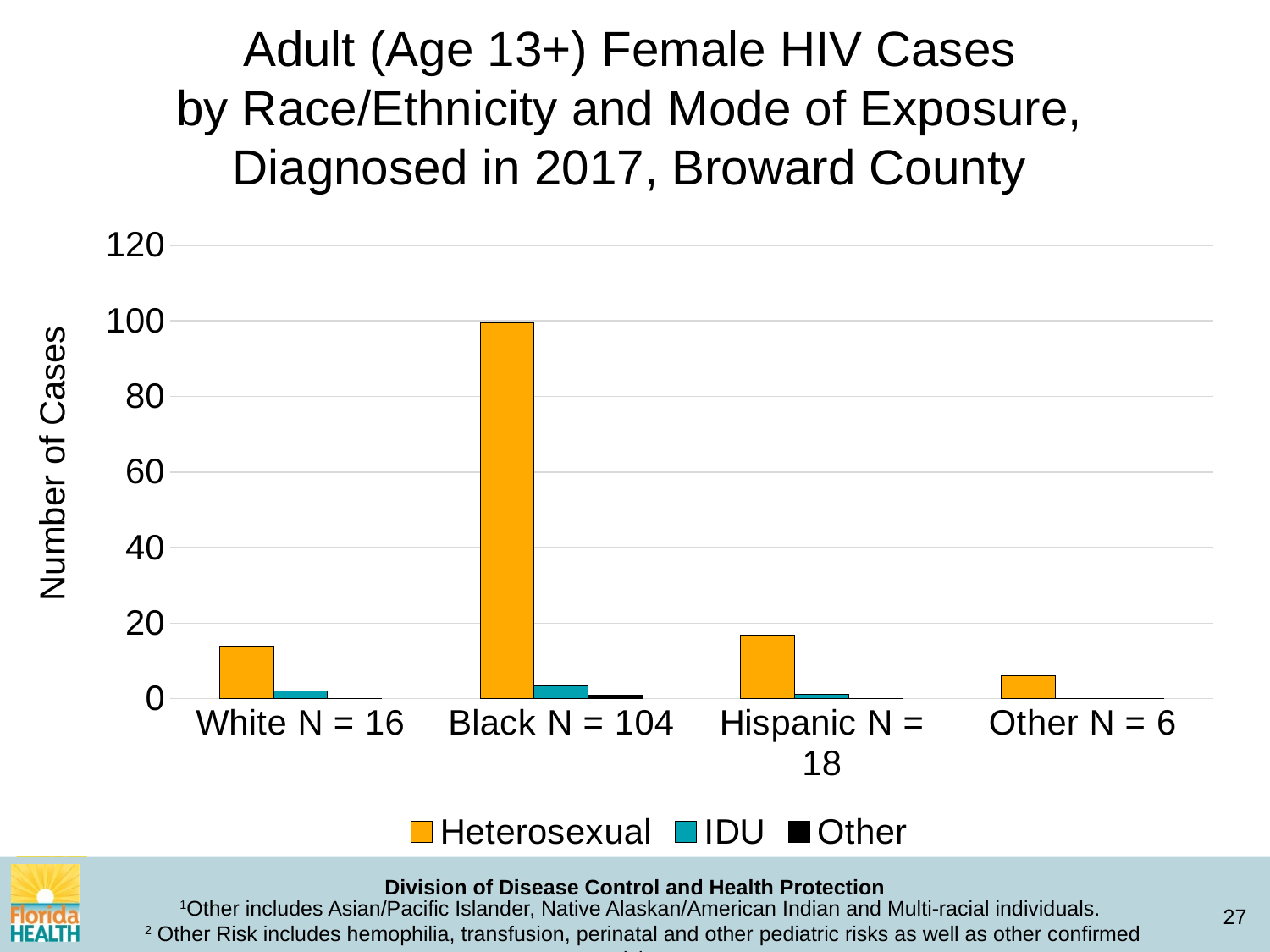
How many series does the legend list? 3 What is the label on the y axis? Number of Cases Is the Heterosexual value for White greater or less than 20? less How many race/ethnicity categories are shown on the x axis? 4 Which race/ethnicity category has the highest Heterosexual bar? Black N = 104 Which is larger, the Heterosexual value for Black or the Heterosexual value for Hispanic? Black Is the IDU value for Black greater or less than 20? less Is the Heterosexual value for Hispanic greater or less than 20? less What kind of chart is shown on the slide? bar chart What are the three modes of exposure listed in the legend? Heterosexual, IDU, Other Which race/ethnicity category has the lowest Heterosexual bar? Other N = 6